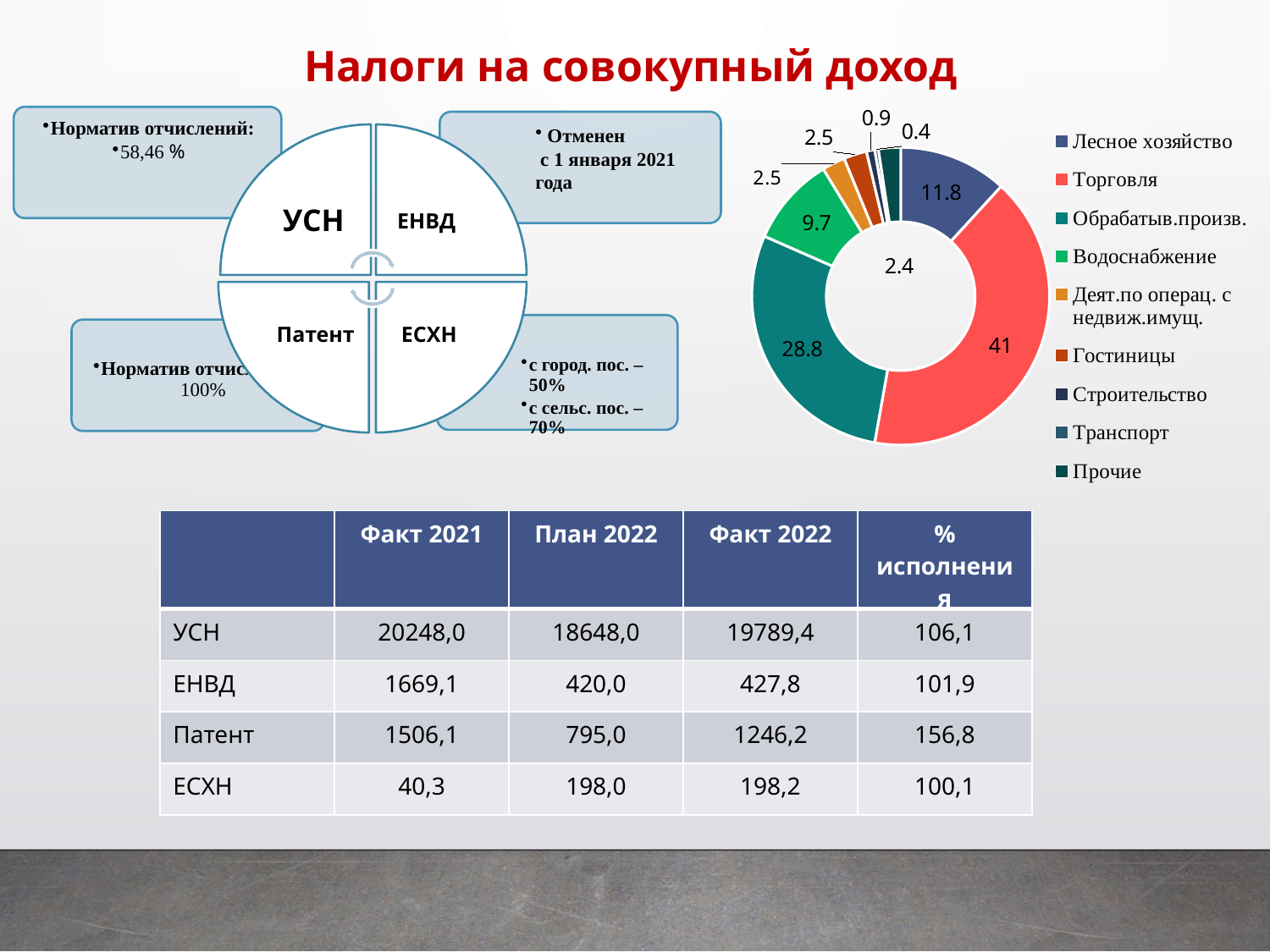
Which category has the largest slice in the doughnut chart? Торговля What is the difference between the values for Торговля and Обрабатыв.произв. in the doughnut chart? 12.2 Which is larger in the doughnut chart, Лесное хозяйство or Водоснабжение? Лесное хозяйство What is the value shown for Водоснабжение in the doughnut chart? 9.7 What is the value shown for Обрабатыв.произв. in the doughnut chart? 28.8 What colour represents Торговля in the doughnut chart? Red What is the value shown for Транспорт in the doughnut chart? 0.4 What kind of chart is shown on the right side of the slide? Doughnut (pie) chart Which category has the smallest slice in the doughnut chart? Транспорт What is the value shown for Торговля in the doughnut chart? 41 How many categories does the legend of the doughnut chart list? 9 What is the value shown for Лесное хозяйство in the doughnut chart? 11.8